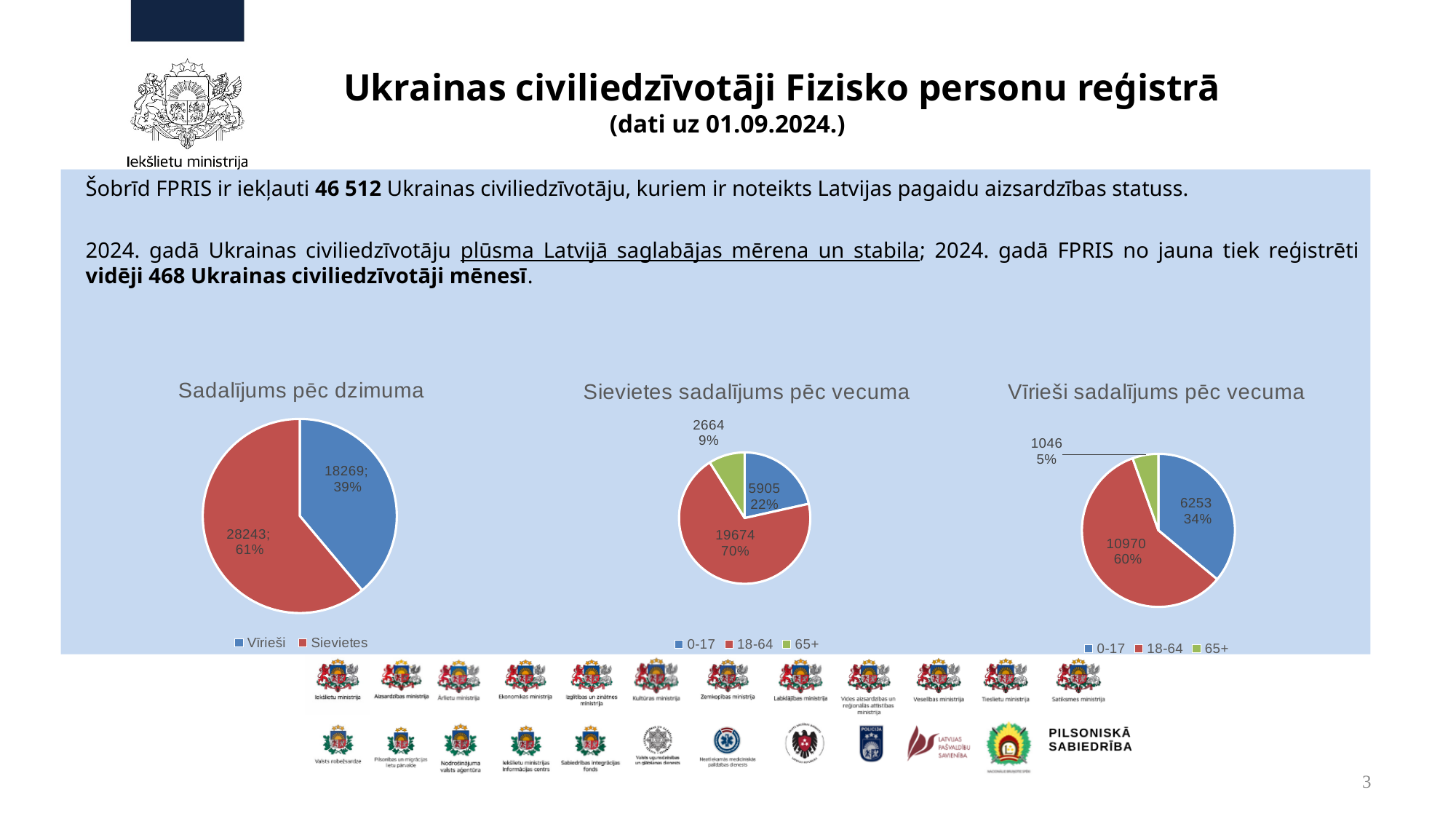
Which is larger: the 0-17 value in "Sievietes sadalījums pēc vecuma" or the 0-17 value in "Vīrieši sadalījums pēc vecuma"? Vīrieši sadalījums pēc vecuma (6253) How many categories does the legend of the chart titled "Vīrieši sadalījums pēc vecuma" list? 3 What type of chart is the chart titled "Sadalījums pēc dzimuma"? Pie chart In the chart titled "Sadalījums pēc dzimuma", what share of the pie is Vīrieši? 39% In the chart titled "Sievietes sadalījums pēc vecuma", what value is shown for the 18-64 group? 19674 In the chart titled "Vīrieši sadalījums pēc vecuma", what value is shown for the 65+ group? 1046 In the chart titled "Vīrieši sadalījums pēc vecuma", which age group is the largest? 18-64 In the chart titled "Sadalījums pēc dzimuma", what value is shown for Sievietes? 28243 In the chart titled "Sievietes sadalījums pēc vecuma", what share of the pie is the 0-17 group? 22% In the chart titled "Sadalījums pēc dzimuma", what is the difference between the Sievietes and Vīrieši values? 9974 In the chart titled "Vīrieši sadalījums pēc vecuma", what share of the pie is the 0-17 group? 34% In the chart titled "Sievietes sadalījums pēc vecuma", which age group is the smallest? 65+